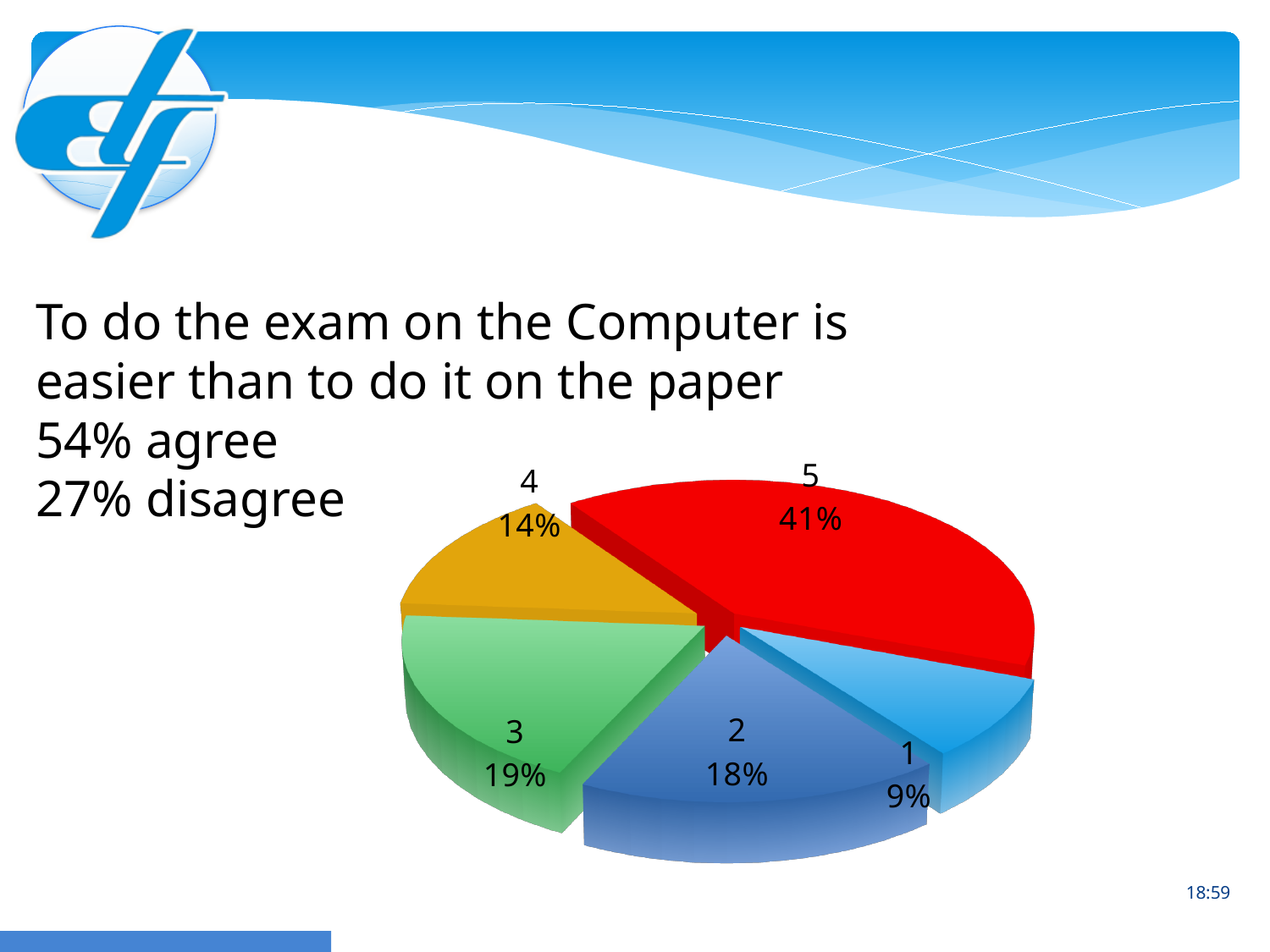
What percentage does slice 1 represent? 9% What percentage does slice 3 represent? 19% What kind of chart is shown on the slide? pie chart Which slice has the smallest share of the pie? 1 What percentage does slice 5 represent? 41% What is the difference in percentage points between slice 5 and slice 2? 23 Which slice has the largest share of the pie? 5 Which is larger, slice 3 or slice 4? 3 What is the combined percentage of slices 4 and 5? 55% What colour is the slice labelled 5? red What percentage does slice 4 represent? 14% How many slices does the pie chart have? 5